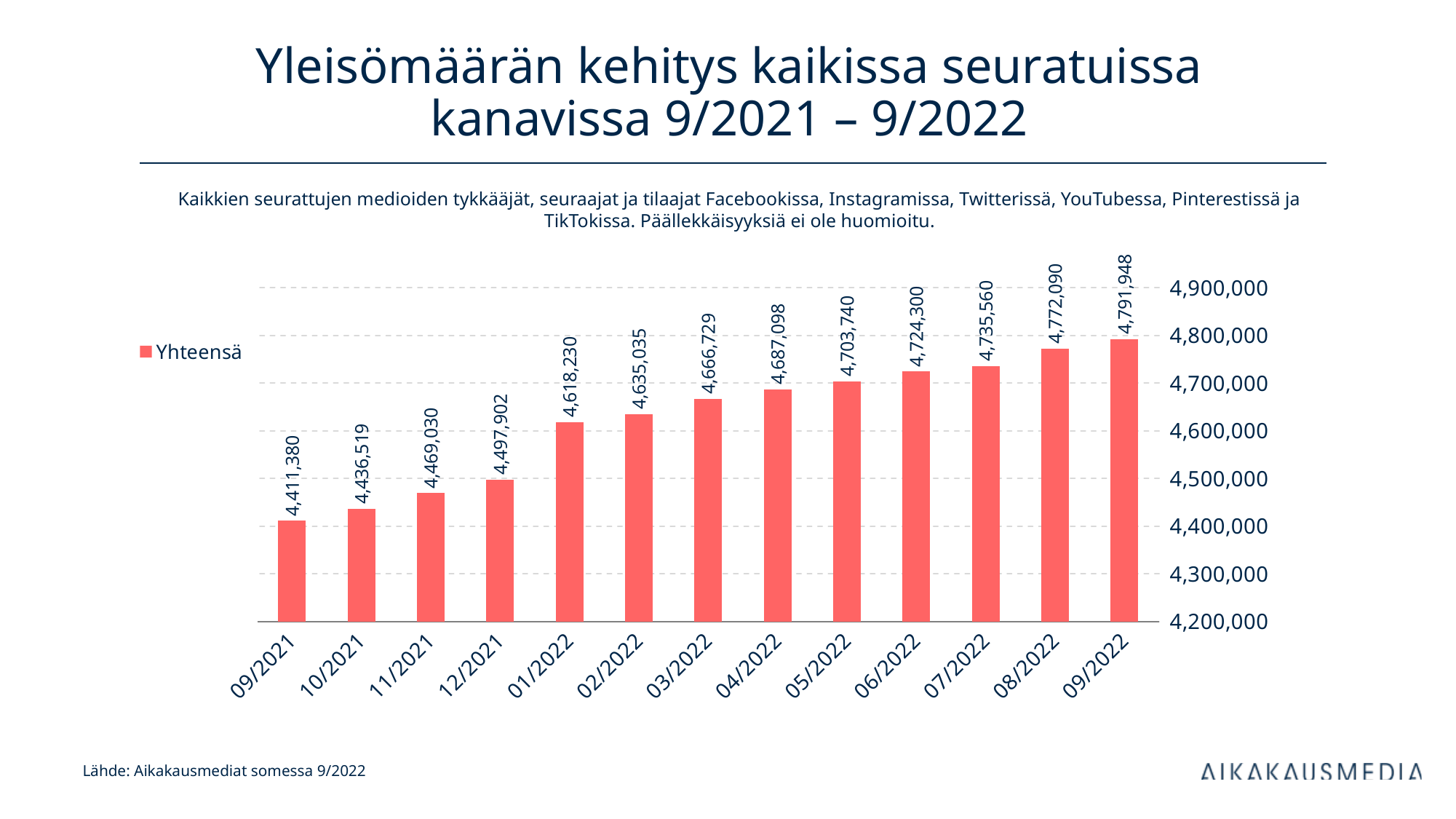
What is the difference between the values for 01/2022 and 12/2021? 120,328 What is the difference between the values for 09/2022 and 09/2021? 380,568 What is the value for 01/2022? 4,618,230 What kind of chart is shown on the slide? bar chart Which is larger, the value for 03/2022 or the value for 11/2021? 03/2022 How many months are shown on the x axis? 13 Do the values rise or fall from 09/2021 to 09/2022? rise Is the value for 12/2021 greater or less than 4,500,000? less What is the value for 09/2021? 4,411,380 Which month has the highest value? 09/2022 What is the value for 05/2022? 4,703,740 Which month has the lowest value? 09/2021